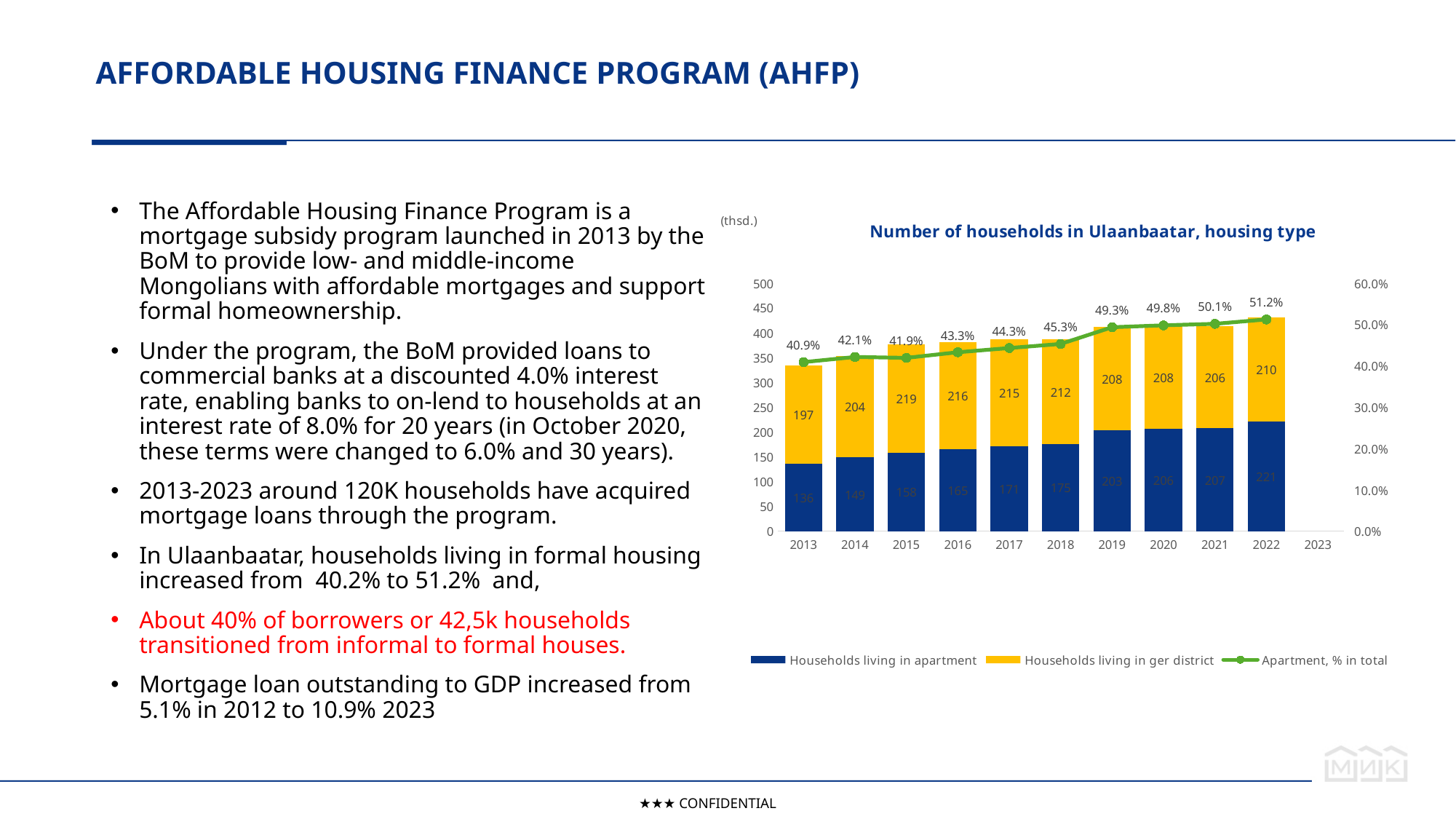
What is the value for households living in ger district in 2015? 219 Which is larger in 2019: households living in apartment or households living in ger district? Households living in ger district In which year is the 'Households living in apartment' value lowest? 2013 What is the value for households living in apartment in 2013? 136 Does the 'Apartment, % in total' line generally rise or fall from 2013 to 2022? Rise In which year is the 'Households living in ger district' value highest? 2015 What kind of chart is used to show the number of households by housing type? Stacked bar chart with a line What is the title of the chart? Number of households in Ulaanbaatar, housing type How many series does the legend list? 3 What is the 'Apartment, % in total' value for 2022? 51.2% What is the difference between households living in apartment in 2022 and in 2013? 85 What is the total number of households (apartment plus ger district) in 2022? 431